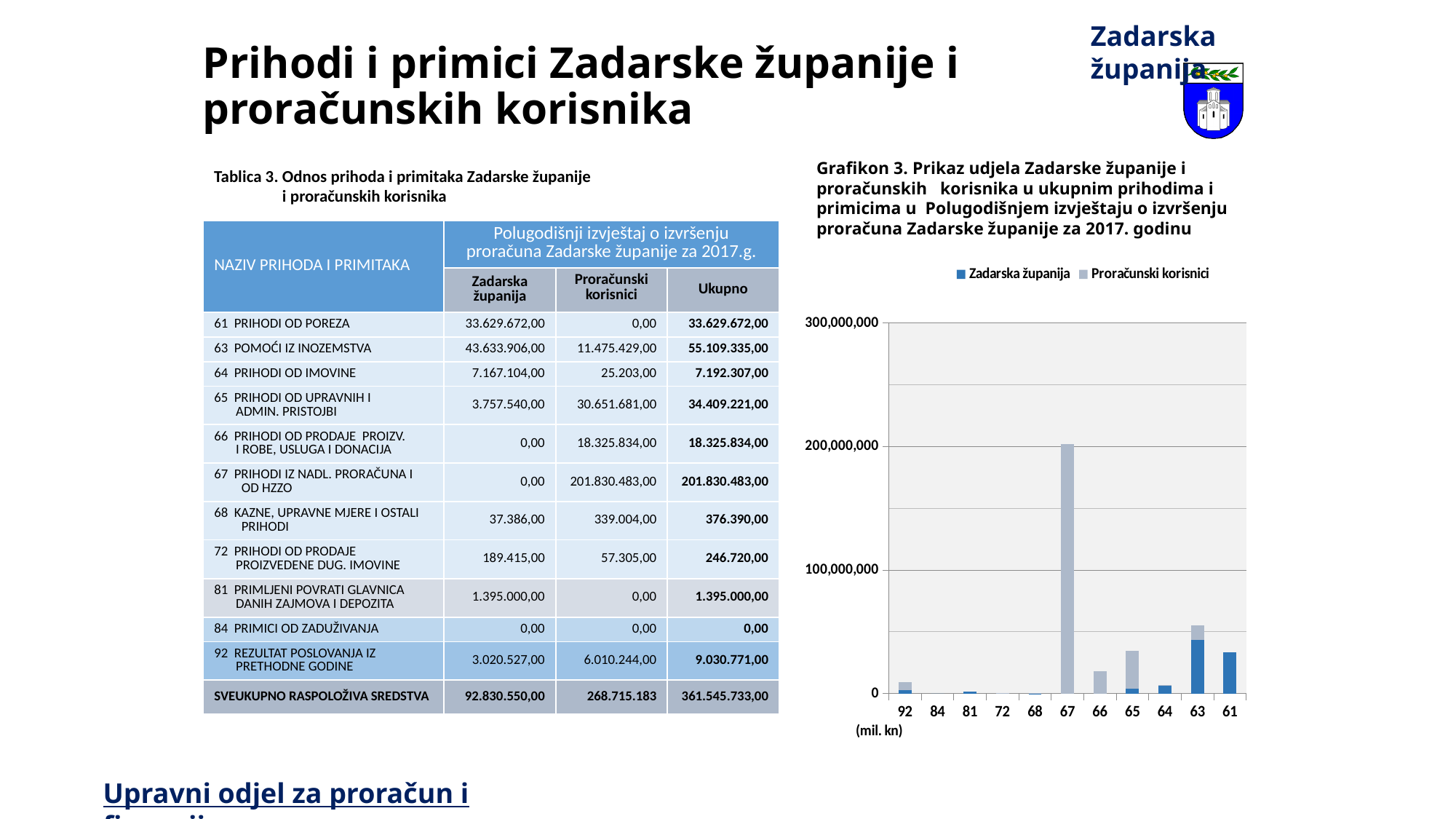
In Grafikon 3, is the total value for category 63 greater or less than 100,000,000? less What unit label is shown below the x axis of Grafikon 3? (mil. kn) In Grafikon 3, which stacked bar is taller, category 67 or category 63? 67 In Grafikon 3, which category has the largest Zadarska županija bar segment? 63 What kind of chart is Grafikon 3? bar chart In Grafikon 3, which stacked bar is taller, category 61 or category 64? 61 In Grafikon 3, which series is shown in dark blue? Zadarska županija In Grafikon 3, is the total value for category 61 greater or less than 100,000,000? less In Grafikon 3, is the total value for category 67 greater or less than 100,000,000? greater How many categories are shown on the x axis of Grafikon 3? 11 In Grafikon 3, which category has the tallest stacked bar? 67 How many series does the legend of Grafikon 3 list? 2